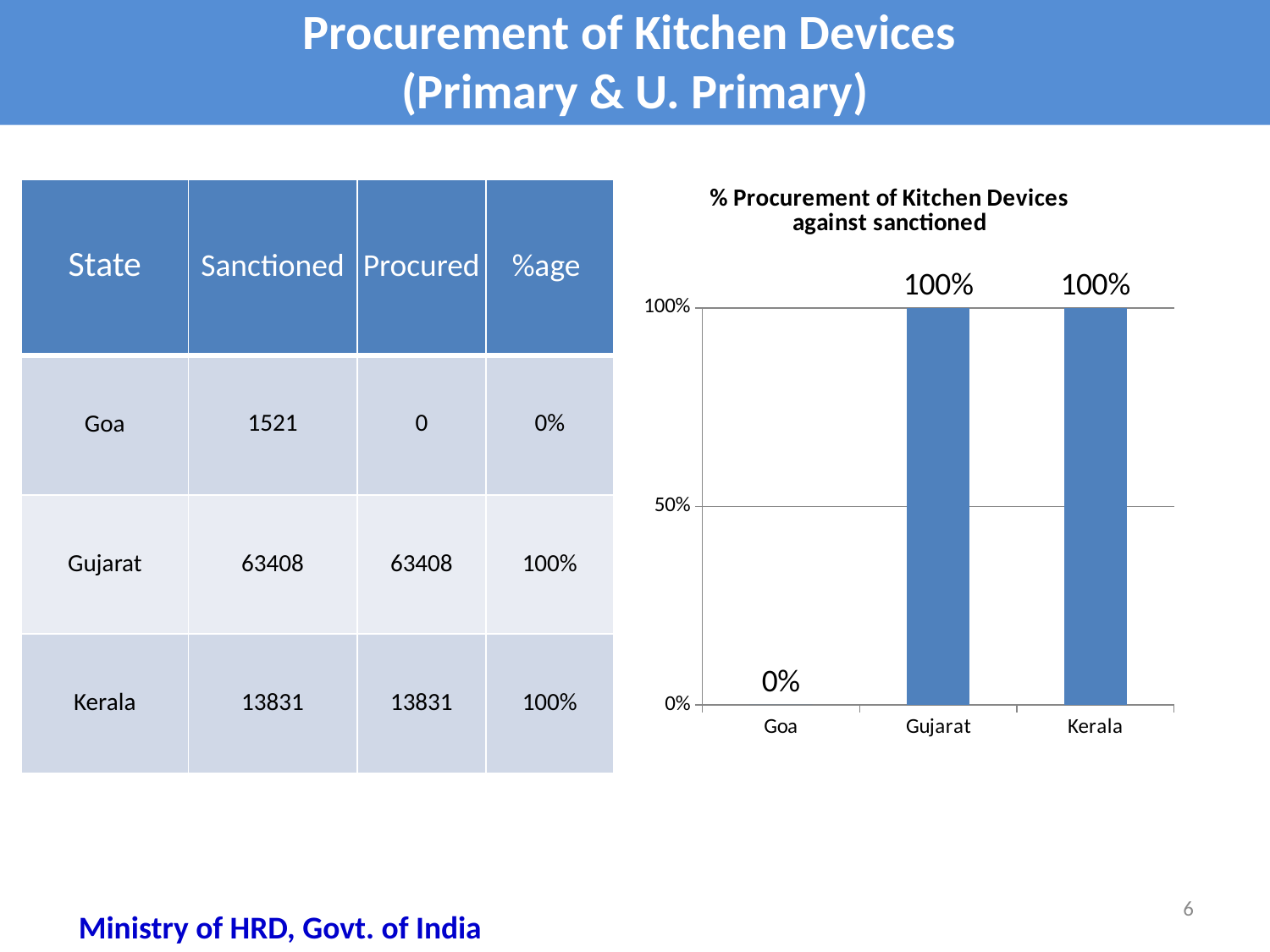
What kind of chart is shown on the slide? bar chart Which state has the lowest value in the chart? Goa What is the value for Gujarat in the chart? 100% Is the value for Gujarat greater or less than 50%? greater What is the highest tick value shown on the y axis of the chart? 100% What is the value for Goa in the chart? 0% What is the value for Kerala in the chart? 100% Which is larger, the value for Kerala or the value for Goa? Kerala What is the title of the chart? % Procurement of Kitchen Devices against sanctioned Is the value for Goa greater or less than 50%? less How many states are shown on the x axis of the chart? 3 What is the difference between the values for Gujarat and Goa? 100%